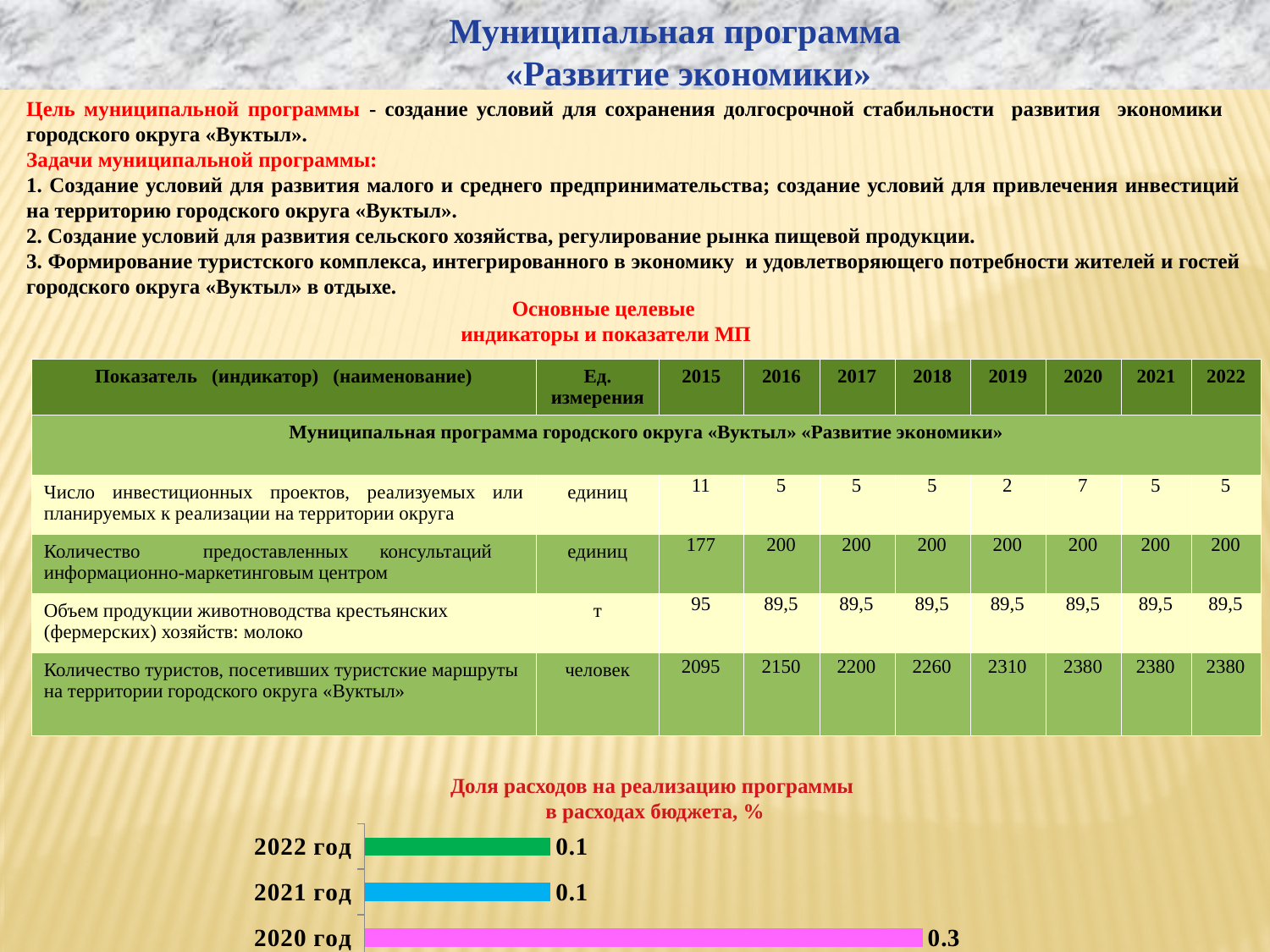
How many years (categories) are shown in the chart? 3 What is the title of the chart? Доля расходов на реализацию программы в расходах бюджета, % What is the value for 2022 год in the chart? 0.1 Which is larger, the value for 2020 год or the value for 2022 год? 2020 год What is the difference between the values for 2020 год and 2021 год? 0.2 Which year has the highest value in the chart? 2020 год What is the value for 2020 год in the chart? 0.3 What type of chart is shown at the bottom of the slide? bar chart What is the value for 2021 год in the chart? 0.1 Do the values rise or fall from 2020 год to 2022 год? fall What colour is the bar for 2020 год? pink